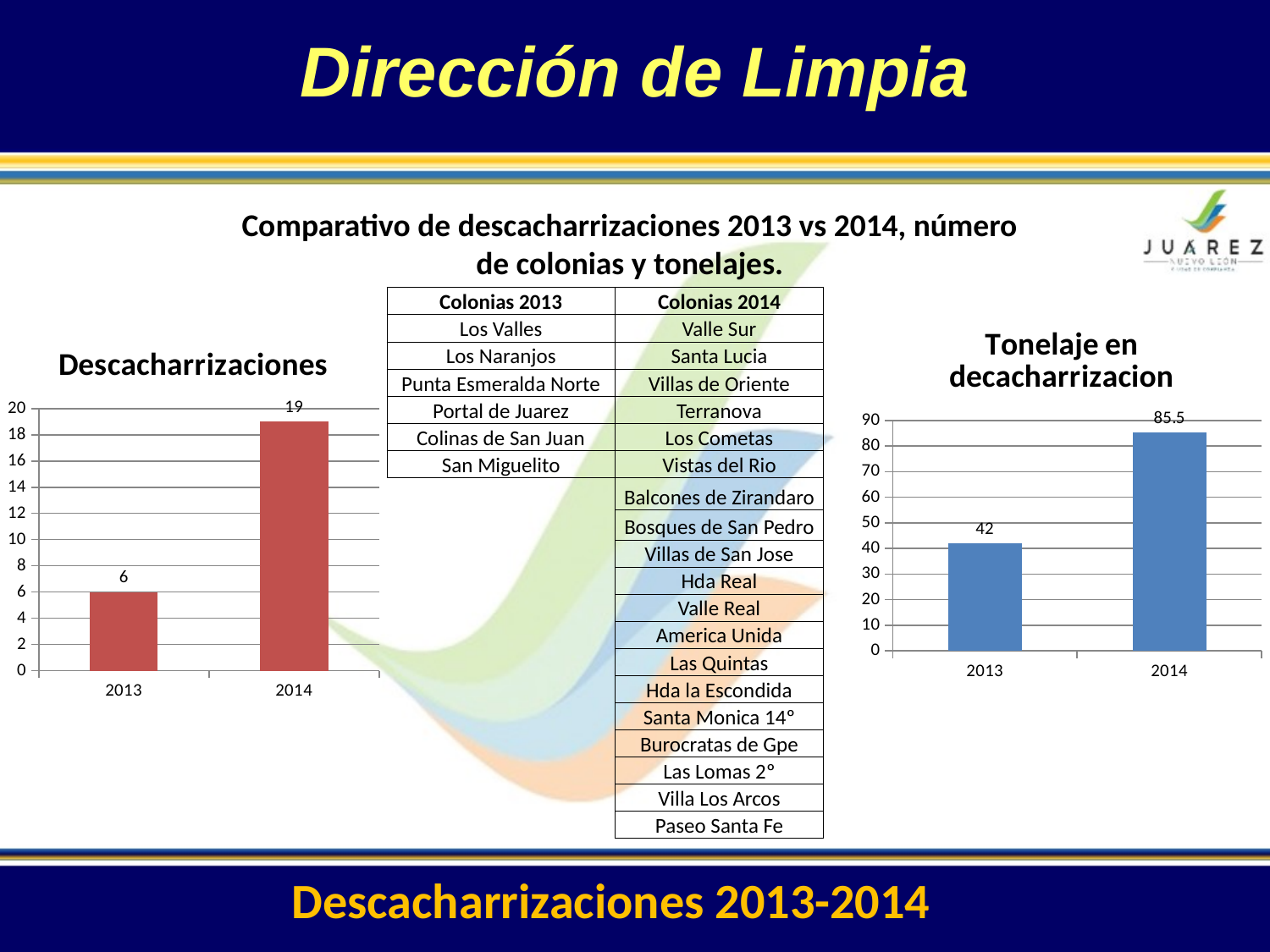
In the 'Tonelaje en decacharrizacion' chart, what is the difference between the 2014 and 2013 values? 43.5 In the 'Descacharrizaciones' chart, what is the difference between the 2014 and 2013 values? 13 In the 'Tonelaje en decacharrizacion' chart, which year has the lower value? 2013 In the 'Descacharrizaciones' chart, which year has the higher value? 2014 In the 'Descacharrizaciones' chart, what is the value for 2014? 19 In the 'Descacharrizaciones' chart, what is the value for 2013? 6 In the 'Tonelaje en decacharrizacion' chart, is the value for 2014 greater or less than 80? greater In the 'Descacharrizaciones' chart, do the values rise or fall from 2013 to 2014? rise How many categories are shown on the x axis of the 'Descacharrizaciones' chart? 2 In the 'Tonelaje en decacharrizacion' chart, what is the value for 2013? 42 In the 'Tonelaje en decacharrizacion' chart, what is the value for 2014? 85.5 What kind of chart is the 'Tonelaje en decacharrizacion' chart? bar chart